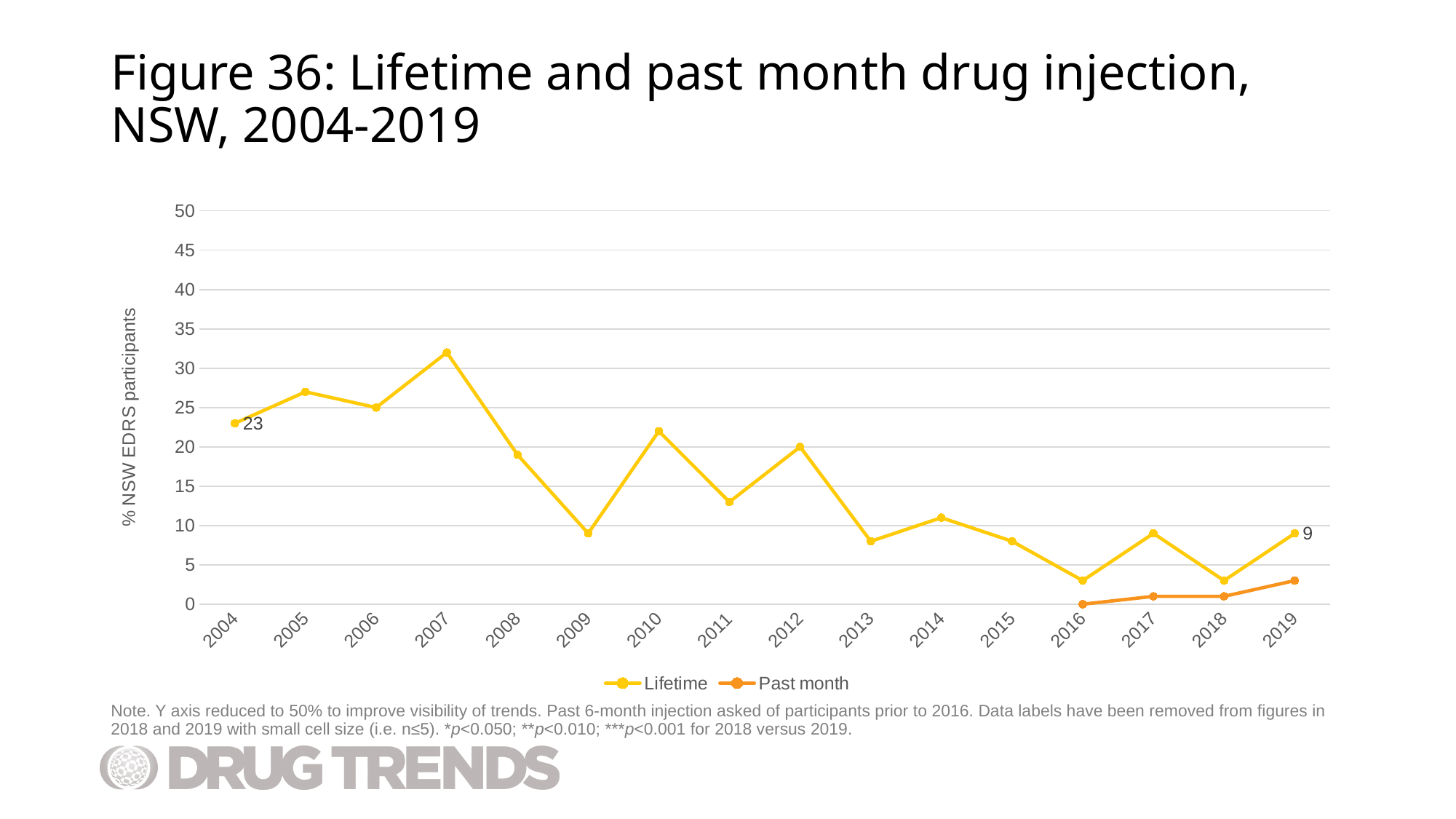
What is the Lifetime value for 2004? 23 In which year is the Past month series at its lowest? 2016 Is the Lifetime value for 2007 greater or less than 30? greater By how much did the Lifetime value fall from 2004 to 2019? 14 How many years are shown on the x axis? 16 What is the Lifetime value for 2019? 9 How many series does the legend list? 2 What kind of chart is shown on the slide? line chart In which year is the Lifetime series at its highest? 2007 Which year has the higher Lifetime value, 2005 or 2006? 2005 Is the Lifetime value for 2009 greater or less than 10? less Is the Lifetime value for 2013 greater or less than 10? less